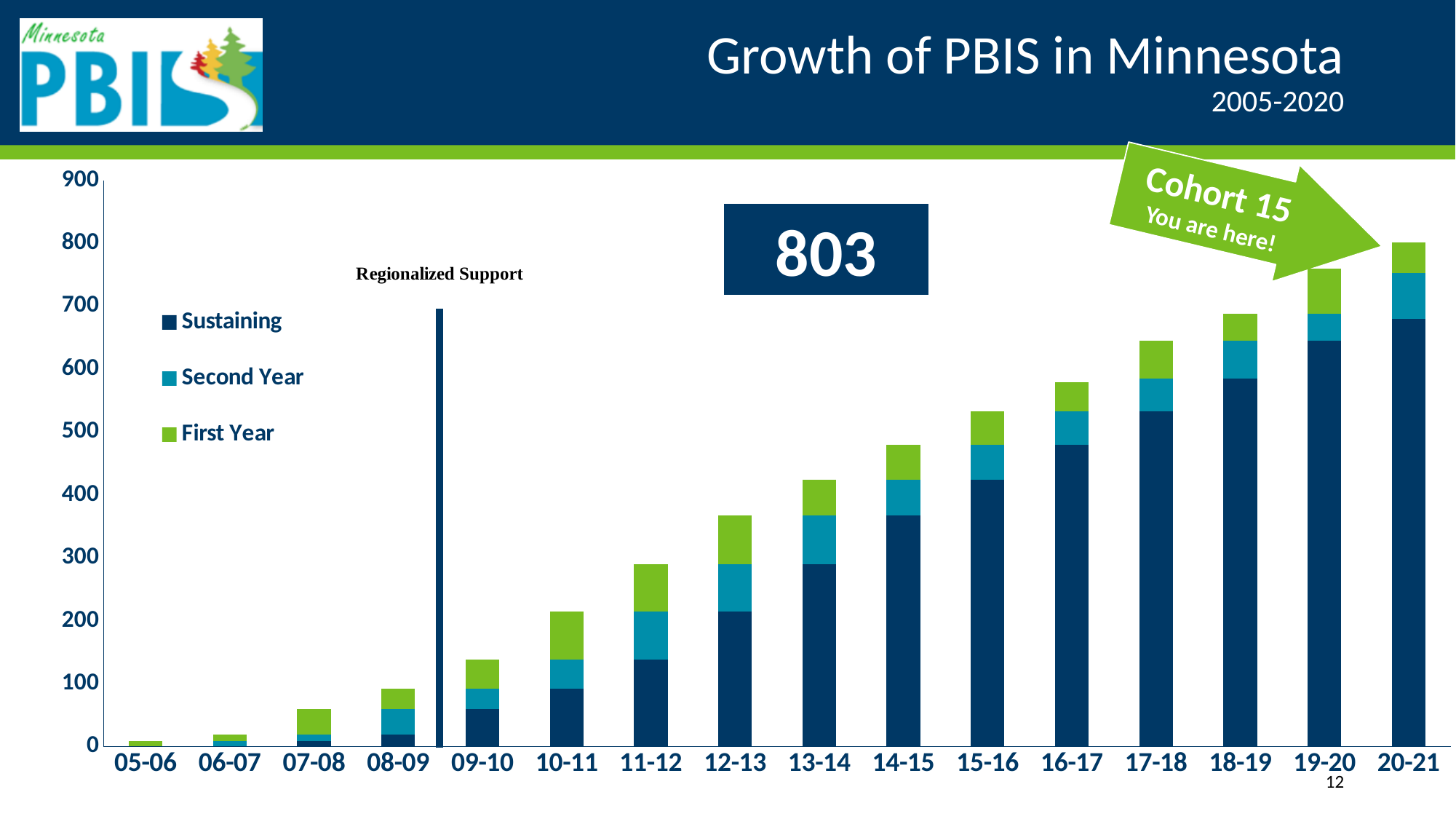
Which legend entry is shown in green? First Year Is the total bar for 15-16 greater or less than 500? greater Do the total bar heights generally rise or fall from 05-06 to 20-21? rise Is the total bar for 20-21 greater or less than 700? greater How many series does the chart legend list? 3 How many school-year categories are shown on the x axis? 16 Is the total bar for 09-10 greater or less than 200? less Which school year has the lowest total bar? 05-06 Is the total bar for 18-19 larger or smaller than the total bar for 11-12? larger What kind of chart is shown on the slide? Stacked bar chart Which school year has the highest total bar? 20-21 What label is written above the vertical line between 08-09 and 09-10? Regionalized Support